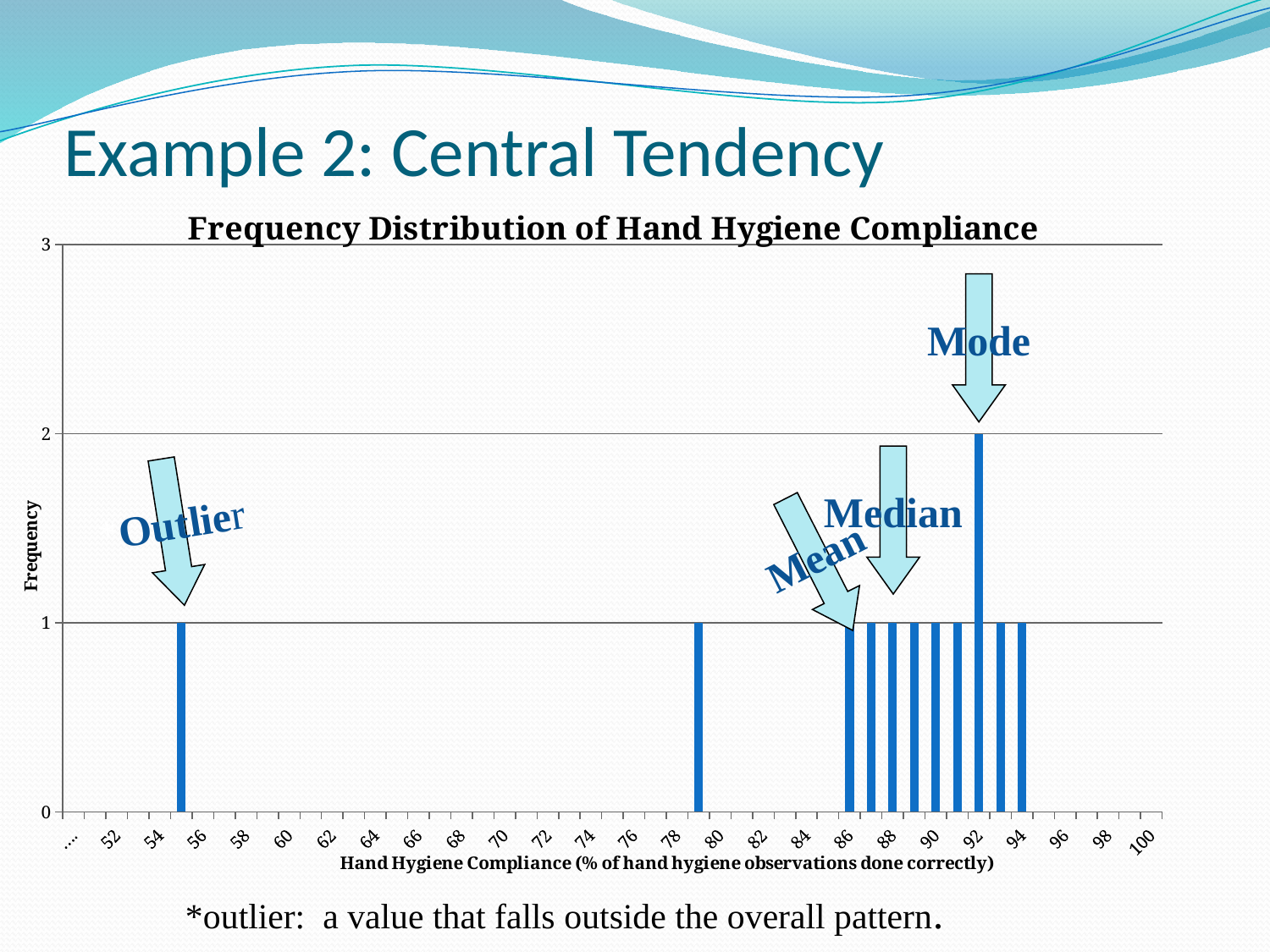
What is the frequency of the tallest bar in the chart? 2 Is the frequency for a compliance of 92 greater or less than 1? greater What is the highest tick value shown on the vertical axis? 3 How many bars are plotted in the chart? 11 Which hand hygiene compliance value has the highest frequency? 92 What kind of chart is shown on the slide? bar chart Which has the higher frequency, a compliance of 92 or a compliance of 90? 92 What is the title of the chart? Frequency Distribution of Hand Hygiene Compliance What is the label on the vertical axis of the chart? Frequency What is the frequency for a hand hygiene compliance of 94? 1 What is the frequency for a hand hygiene compliance of 86? 1 What is the difference between the frequency at 92 and the frequency at 88? 1